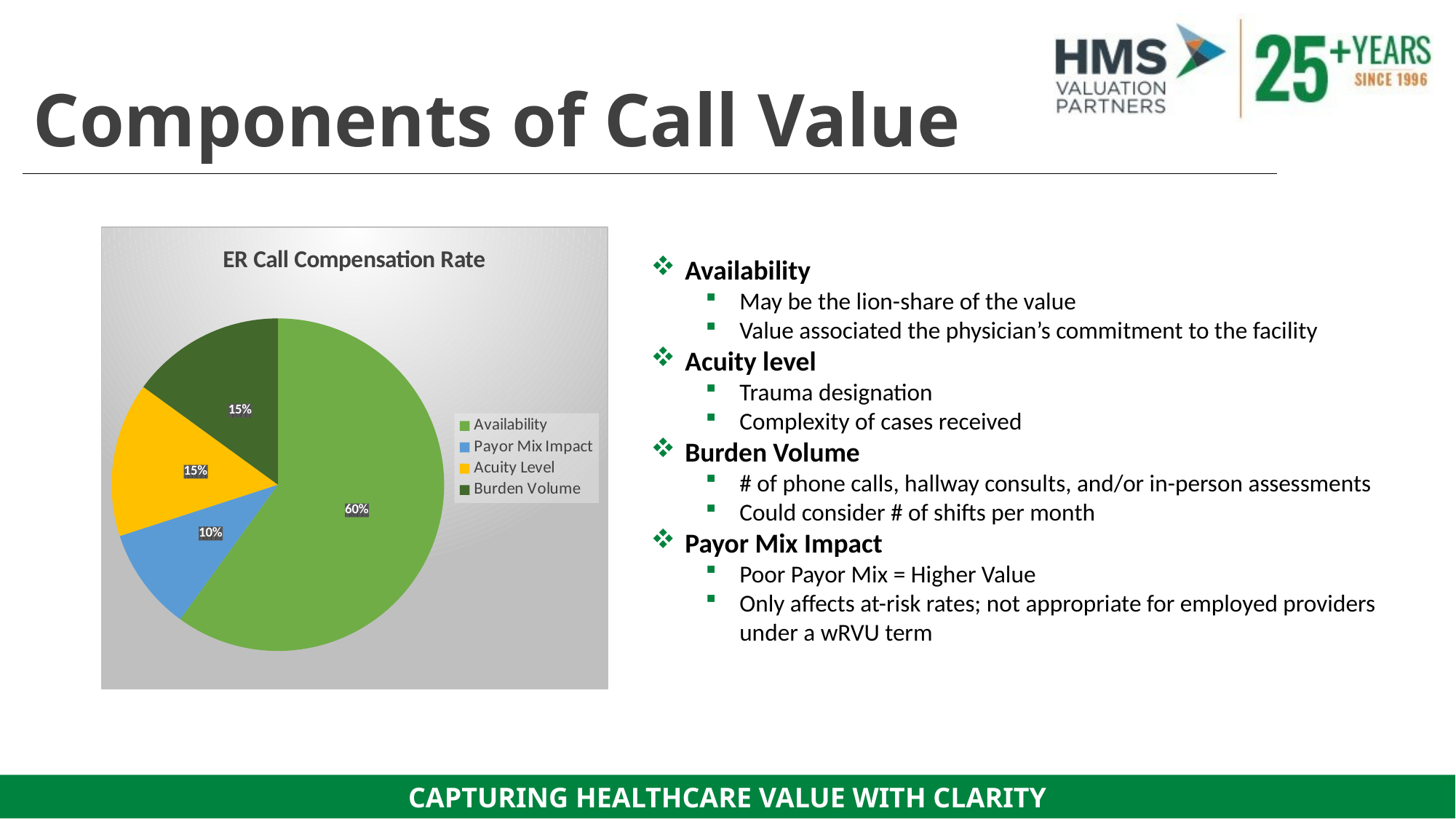
What share of the pie does Acuity Level represent? 15% What is the title of the pie chart? ER Call Compensation Rate Which category has the largest slice of the pie? Availability Which is larger, the Acuity Level share or the Payor Mix Impact share? Acuity Level What share of the pie does Payor Mix Impact represent? 10% What type of chart is shown on the slide? pie chart What is the difference between the Availability share and the Payor Mix Impact share? 50% What share of the pie does Burden Volume represent? 15% What colour is the Acuity Level slice? yellow What share of the pie does Availability represent? 60% How many categories does the pie chart have? 4 Which category has the smallest slice of the pie? Payor Mix Impact